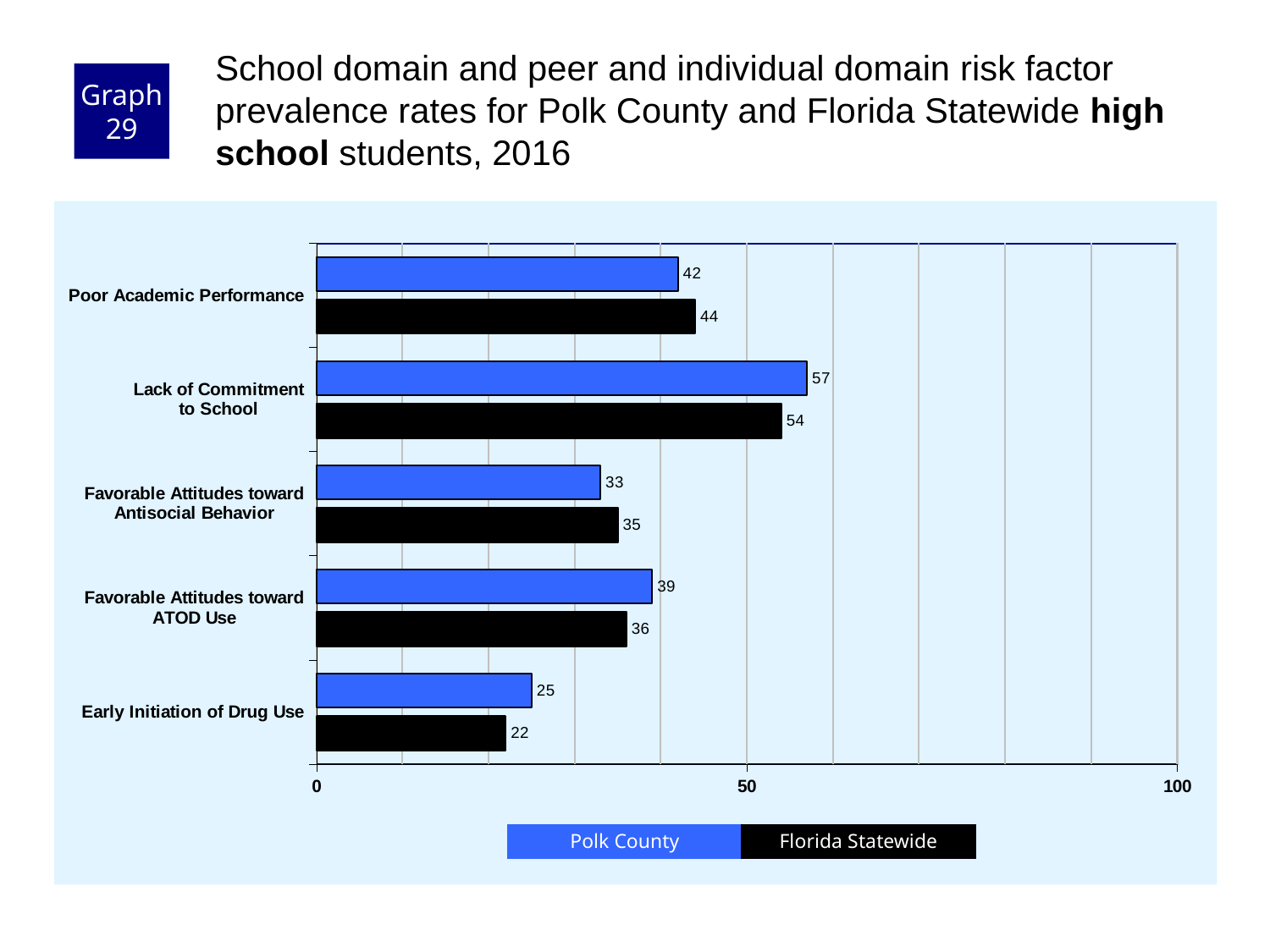
What is the Florida Statewide value for Early Initiation of Drug Use? 22 What is the Florida Statewide value for Poor Academic Performance? 44 Which risk factor has the lowest Florida Statewide value? Early Initiation of Drug Use What is the difference between the Polk County and Florida Statewide values for Favorable Attitudes toward ATOD Use? 3 Which risk factor has the highest Polk County value? Lack of Commitment to School For Favorable Attitudes toward Antisocial Behavior, which is larger: Polk County or Florida Statewide? Florida Statewide What is the Polk County value for Lack of Commitment to School? 57 How many risk factor categories are shown on the chart? 5 Is the Polk County value for Lack of Commitment to School greater or less than 50? greater How many series does the legend list? 2 What kind of chart is shown on the slide? bar chart Which colour represents Florida Statewide in the chart? black